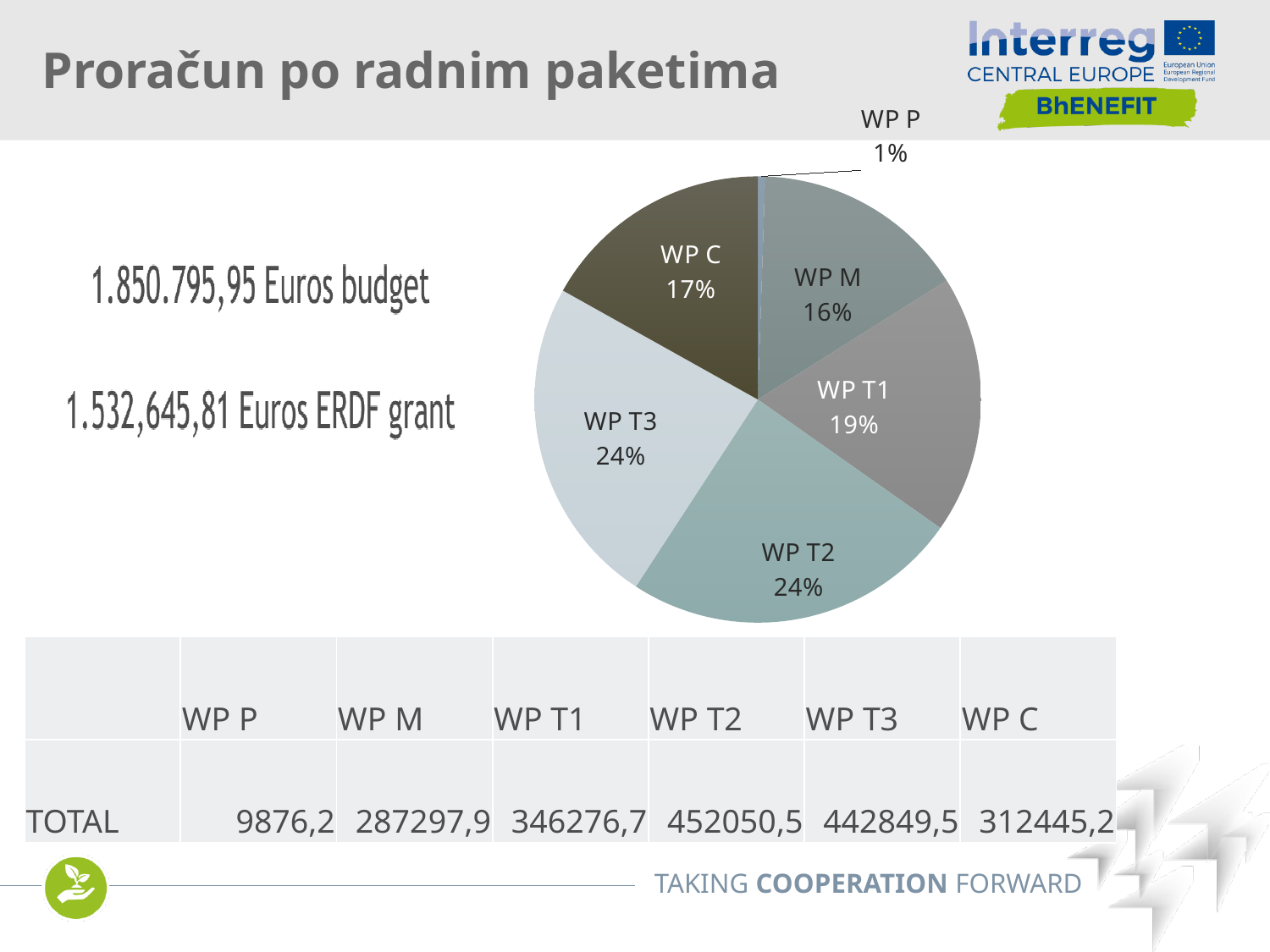
What kind of chart is shown on the slide? pie chart Which two work packages share the same percentage of 24%? WP T2 and WP T3 Which is larger, the share for WP T1 or the share for WP M? WP T1 How many slices does the pie chart have? 6 What is the difference in percentage points between the WP T2 share and the WP T1 share? 5% What is the difference in percentage points between the WP C share and the WP M share? 1% What share of the pie does WP C represent? 17% What share of the pie does WP T3 represent? 24% What share of the pie does WP T1 represent? 19% Which work package has the smallest slice of the pie? WP P